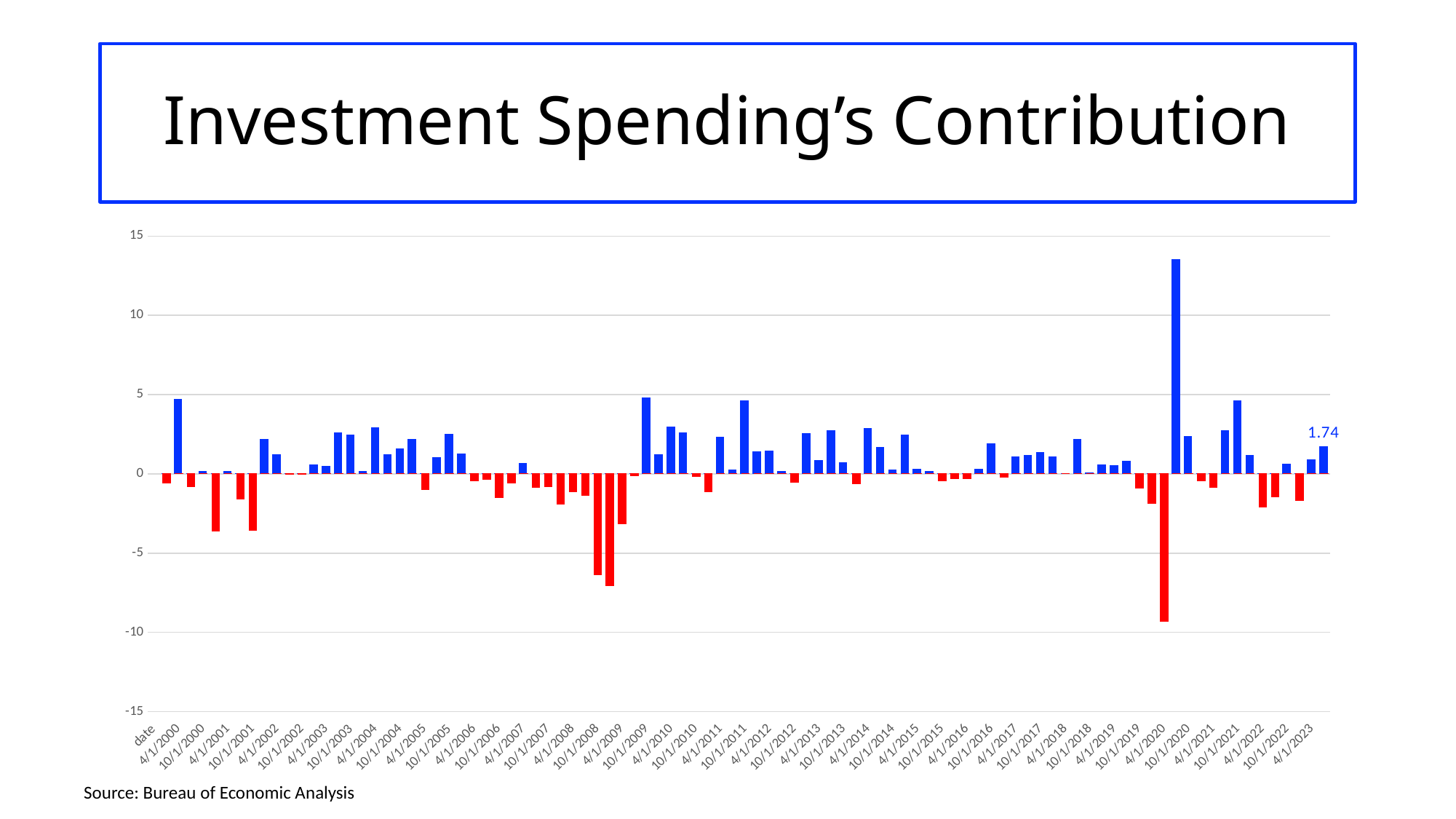
Is the value for 10/1/2020 greater or less than 5? less Is the value for 4/1/2020 greater or less than -5? less What source is cited below the chart? Bureau of Economic Analysis Is the tallest bar on the chart greater or less than 10? greater What is the highest value shown on the y axis? 15 What value is printed as a data label on the rightmost bar of the chart? 1.74 Which date has the lowest value on the chart? 4/1/2020 Which is larger, the value for 4/1/2020 or the value for 10/1/2020? 10/1/2020 What kind of chart is shown on the slide? bar chart